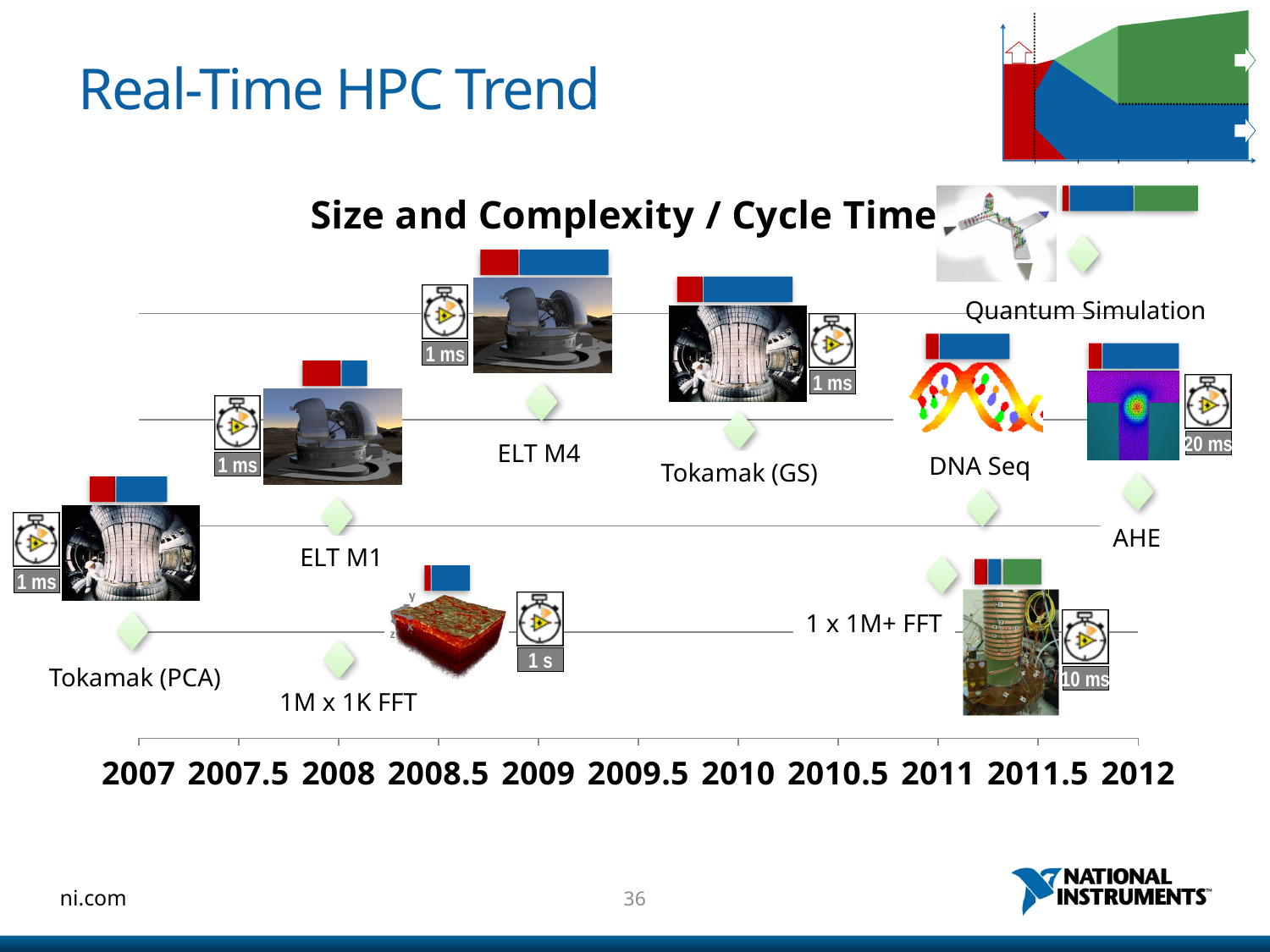
What cycle time is labelled for 1 x 1M+ FFT? 10 ms Which project is plotted at 2010 on the x axis? Tokamak (GS) What is the latest year shown on the x axis of the chart? 2012 How many project markers (diamonds) are plotted on the chart? 9 What is the earliest year shown on the x axis of the chart? 2007 Which has the longer labelled cycle time, AHE or 1 x 1M+ FFT? AHE What cycle time is labelled for 1M x 1K FFT? 1 s What cycle time is labelled for ELT M4? 1 ms What cycle time is labelled for AHE? 20 ms What is the title of the chart on the slide? Size and Complexity / Cycle Time Which has the longer labelled cycle time, 1M x 1K FFT or ELT M1? 1M x 1K FFT What cycle time is labelled for Tokamak (PCA)? 1 ms